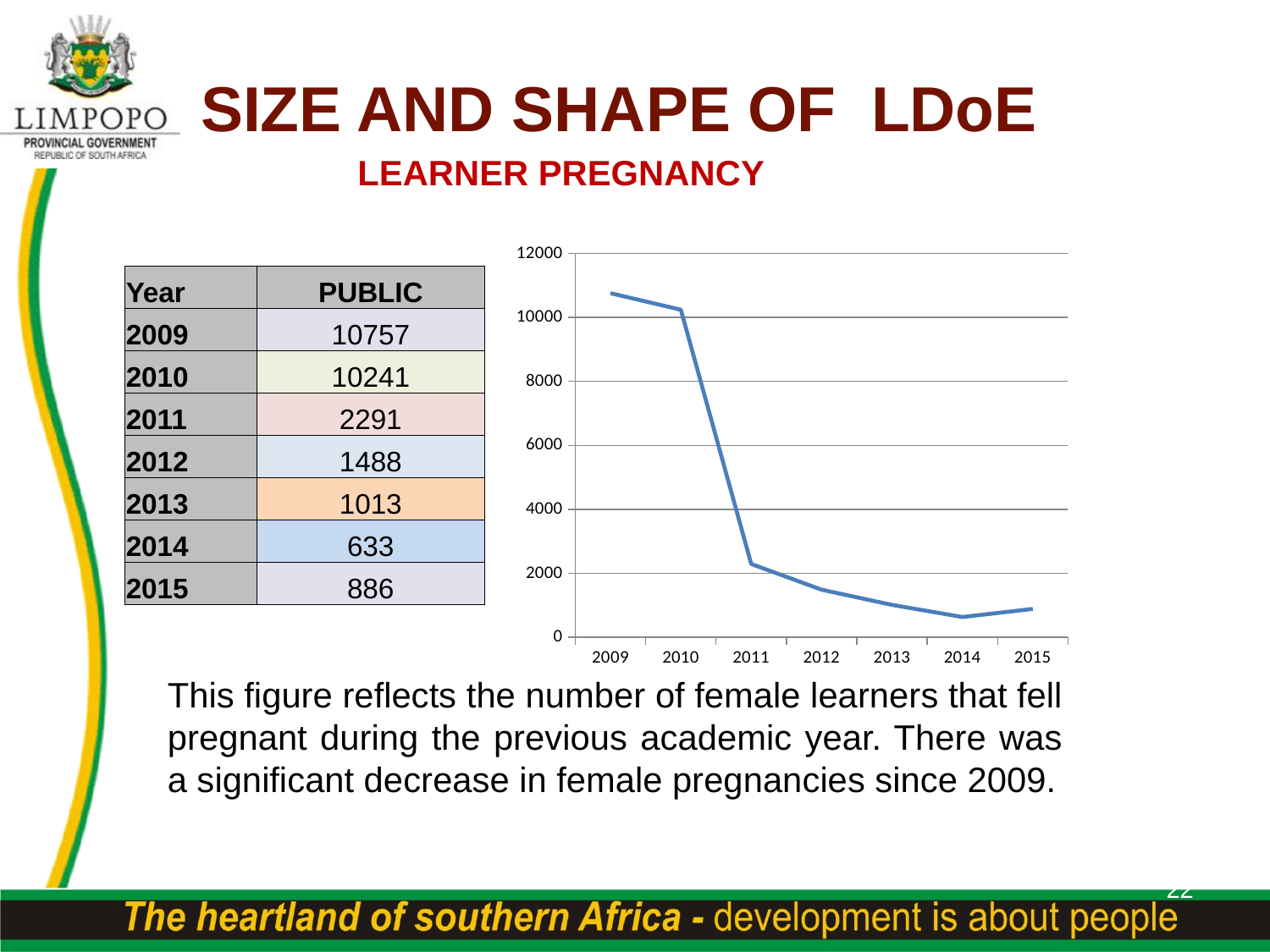
What is the difference between the values for 2010 and 2011? 7950 Which year has the highest value? 2009 What is the value for 2011? 2291 What kind of chart is shown on the slide? line chart Which year has the lowest value? 2014 What is the value for 2009? 10757 What is the value for 2014? 633 How many years are plotted on the x axis of the chart? 7 What is the difference between the values for 2009 and 2015? 9871 Is the value for 2012 greater or less than 2000? less Which is larger, the value for 2014 or the value for 2015? 2015 Do the values generally rise or fall from 2009 to 2014? fall